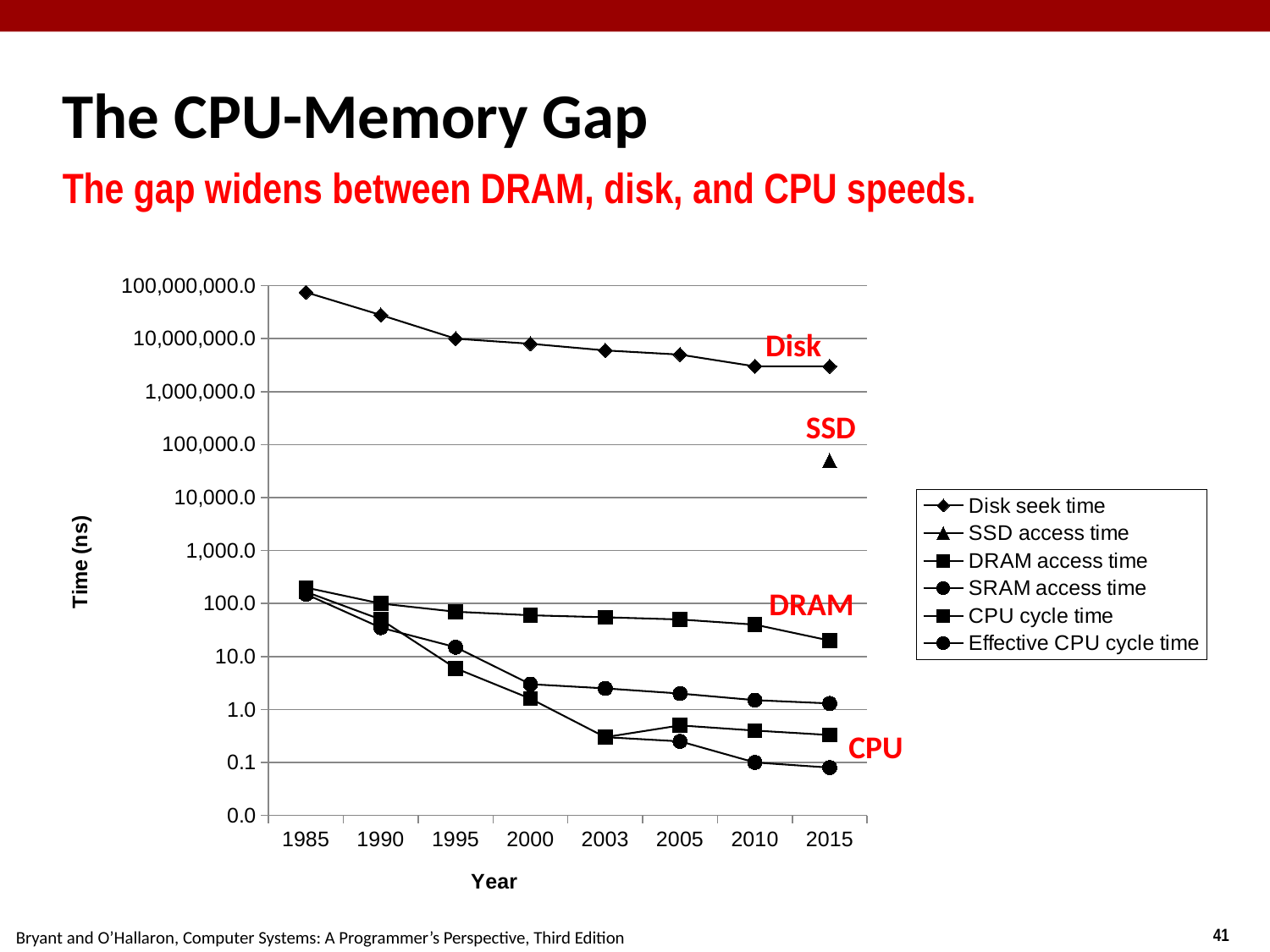
Is the Disk seek time in 2015 greater or less than 10,000,000.0? less Is the DRAM access time in 2015 greater or less than 10.0? greater Does the Disk seek time rise or fall from 1985 to 2015? fall How many years are shown along the x axis? 8 Is the CPU cycle time in 2015 greater or less than 1.0? less How many series does the legend list? 6 Which series has the highest values across all years? Disk seek time In 2015, which is larger: DRAM access time or CPU cycle time? DRAM access time What is the label of the y axis? Time (ns) What kind of chart is shown on the slide? line chart